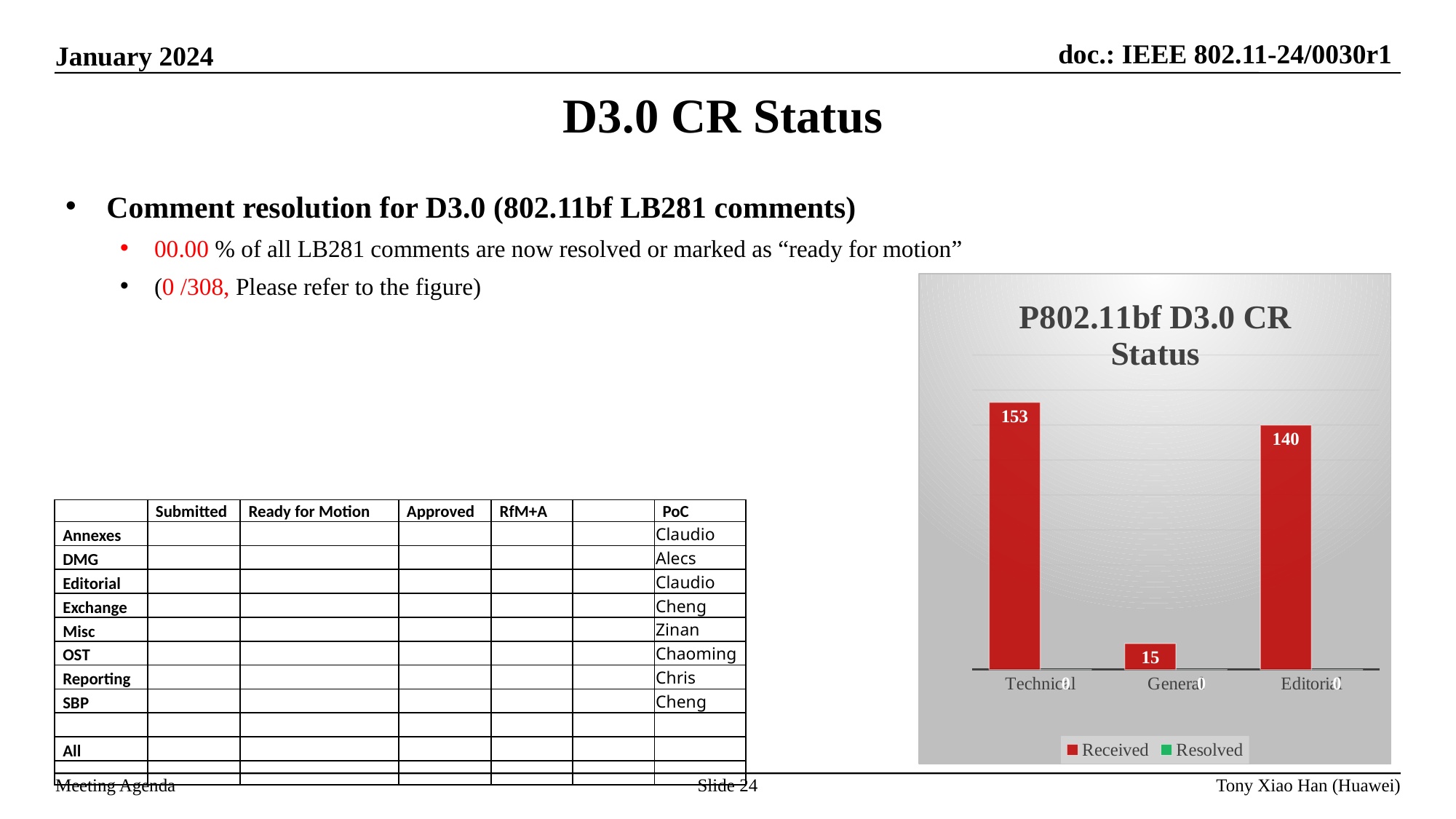
Which category has the highest Received value? Technical What is the Received value for Technical? 153 How many series does the chart legend list? 2 Which category has the lowest Received value? General What is the difference between the Received values for Technical and Editorial? 13 Which is larger, the Received value for General or for Editorial? Editorial What is the Received value for General? 15 What is the title of the chart? P802.11bf D3.0 CR Status What is the Resolved value for Technical? 0 What type of chart is shown on the slide? bar chart How many categories are shown on the x axis of the chart? 3 What is the Received value for Editorial? 140